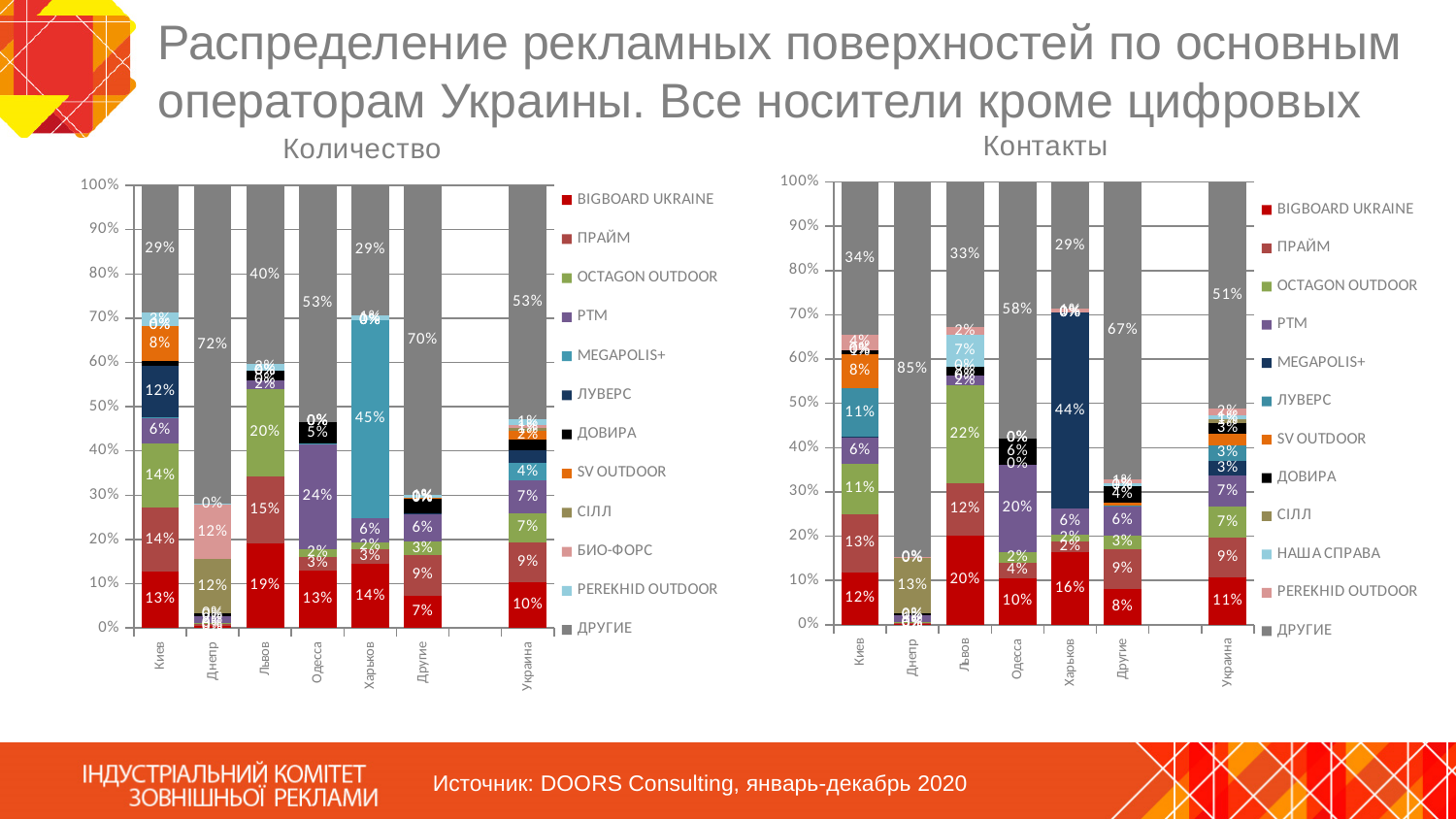
In the "Количество" chart, what is the value of ДРУГИЕ for Днепр? 72% What is the title of the chart on the right side of the slide? Контакты Is the ДРУГИЕ share for Украина larger in the "Количество" chart or in the "Контакты" chart? Количество In the "Количество" chart, what is the value of BIGBOARD UKRAINE for Львов? 19% In the "Количество" chart, what is the value of РТМ for Одесса? 24% How many series does the legend of the "Количество" chart list? 12 How many categories are shown on the x axis of the "Контакты" chart? 7 In the "Количество" chart, what is the difference between the ДРУГИЕ value for Другие and for Киев? 41 percentage points In the "Контакты" chart, what is the value of MEGAPOLIS+ for Харьков? 44% In the "Контакты" chart, what is the value of ДРУГИЕ for Днепр? 85% What kind of chart is the "Количество" chart? Stacked bar chart In the "Количество" chart, which category has the highest ДРУГИЕ share? Днепр